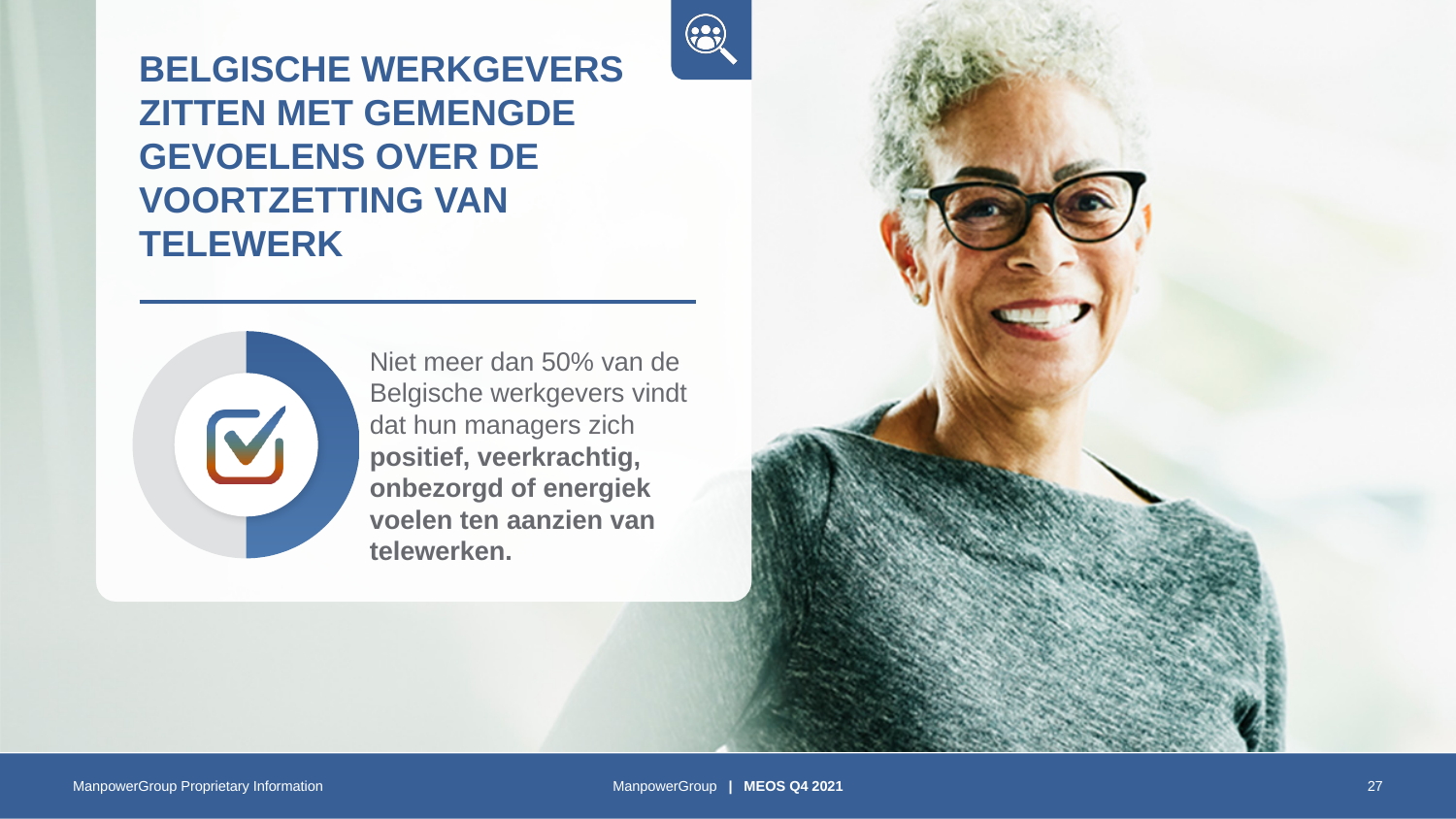
What kind of chart is shown on the left of the slide? Donut (pie) chart What icon is shown in the centre of the donut chart? A checkmark in a box How many segments does the donut chart have? 2 What share of the donut chart is filled in blue? 50% Is the blue portion of the donut chart greater or less than 75%? less What colour is the highlighted segment of the donut chart? Blue Is the blue portion of the donut chart greater or less than 25%? greater